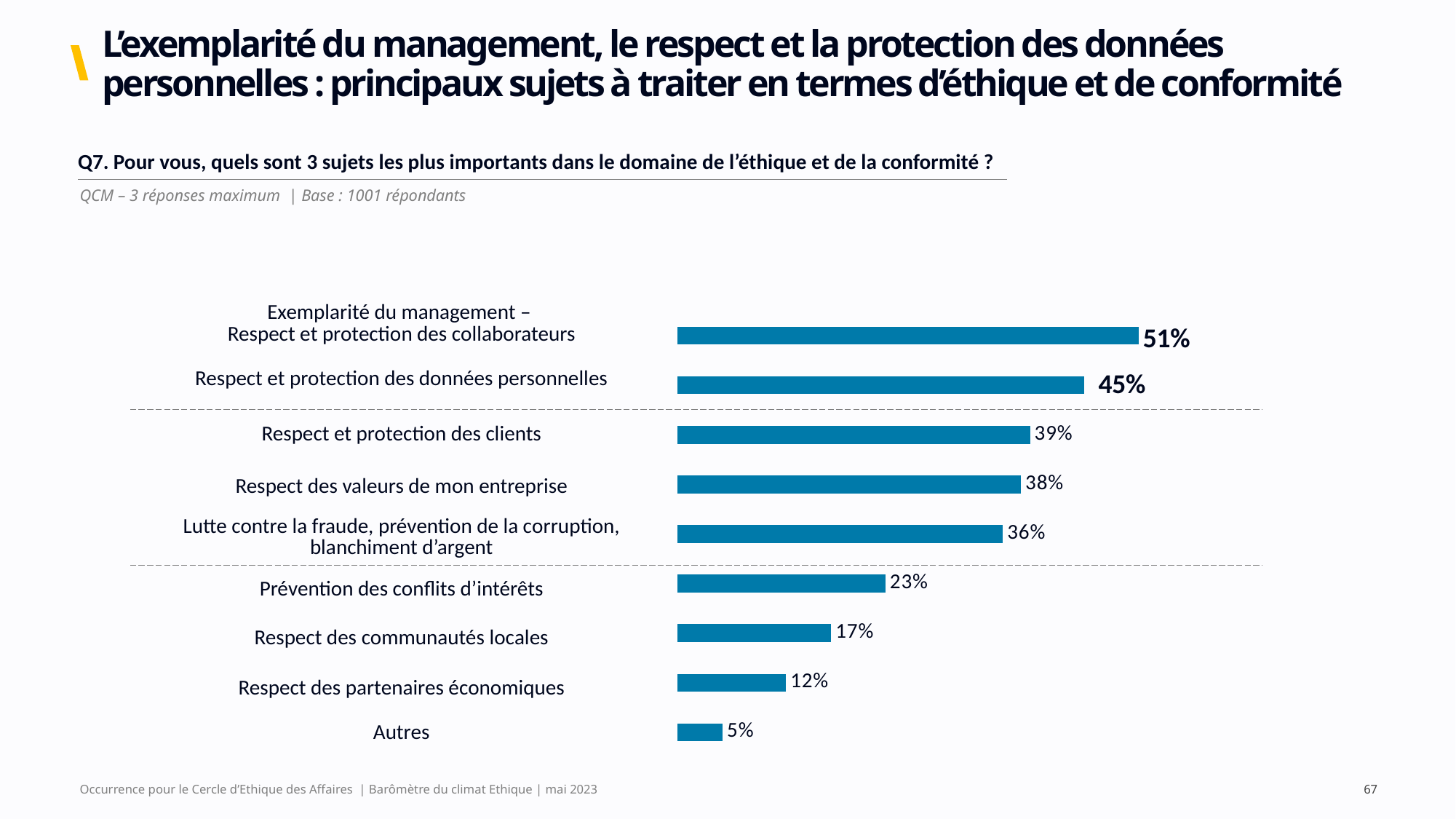
What is the value for "Lutte contre la fraude, prévention de la corruption, blanchiment d'argent"? 36% What is the value for "Respect des partenaires économiques"? 12% Which is larger: "Respect des valeurs de mon entreprise" or "Lutte contre la fraude, prévention de la corruption, blanchiment d'argent"? Respect des valeurs de mon entreprise What is the difference between "Respect et protection des clients" and "Respect des communautés locales"? 22 percentage points What kind of chart is shown on the slide? Bar chart What is the difference between the two highest values, 51% and 45%? 6 percentage points How many categories are shown in the chart? 9 Which category has the lowest value? Autres What is the value for "Prévention des conflits d'intérêts"? 23% What is the base number of respondents stated for the chart? 1001 répondants Which category has the highest value? Exemplarité du management – Respect et protection des collaborateurs What is the value for "Respect et protection des données personnelles"? 45%